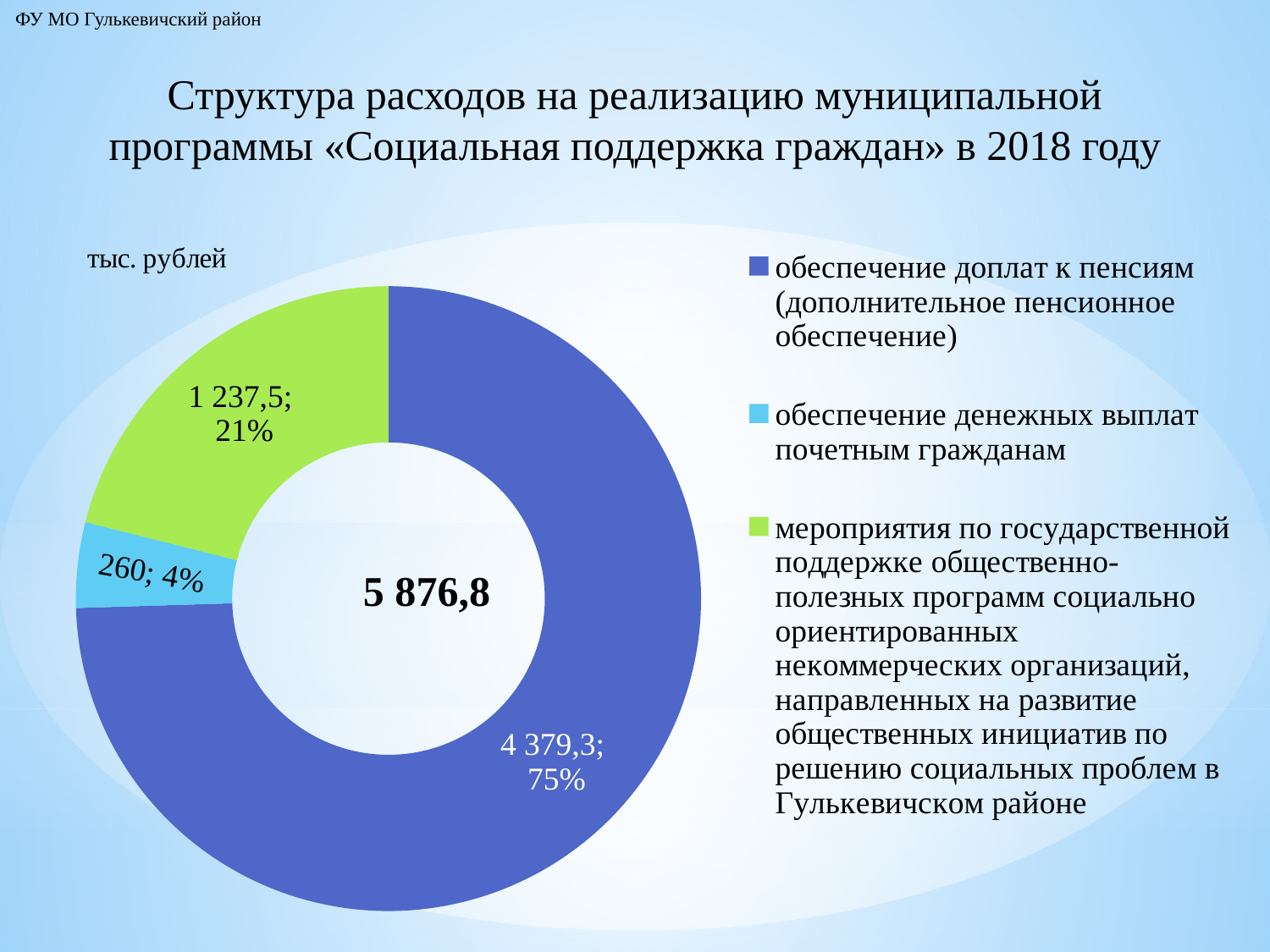
What is the value for «мероприятия по государственной поддержке общественно-полезных программ социально ориентированных некоммерческих организаций...»? 1 237,5 Which category has the largest value? обеспечение доплат к пенсиям (дополнительное пенсионное обеспечение) What share of the chart does «обеспечение денежных выплат почетным гражданам» take? 4% What share of the chart does «обеспечение доплат к пенсиям» take? 75% How many categories does the legend list? 3 What is the value for «обеспечение доплат к пенсиям (дополнительное пенсионное обеспечение)»? 4 379,3 What unit is indicated for the chart values? тыс. рублей What is the total shown in the centre of the chart? 5 876,8 What share of the chart does the green slice (мероприятия по государственной поддержке...) take? 21% Which category has the smallest value? обеспечение денежных выплат почетным гражданам What kind of chart is shown on the slide? Doughnut (pie) chart What is the value for «обеспечение денежных выплат почетным гражданам»? 260